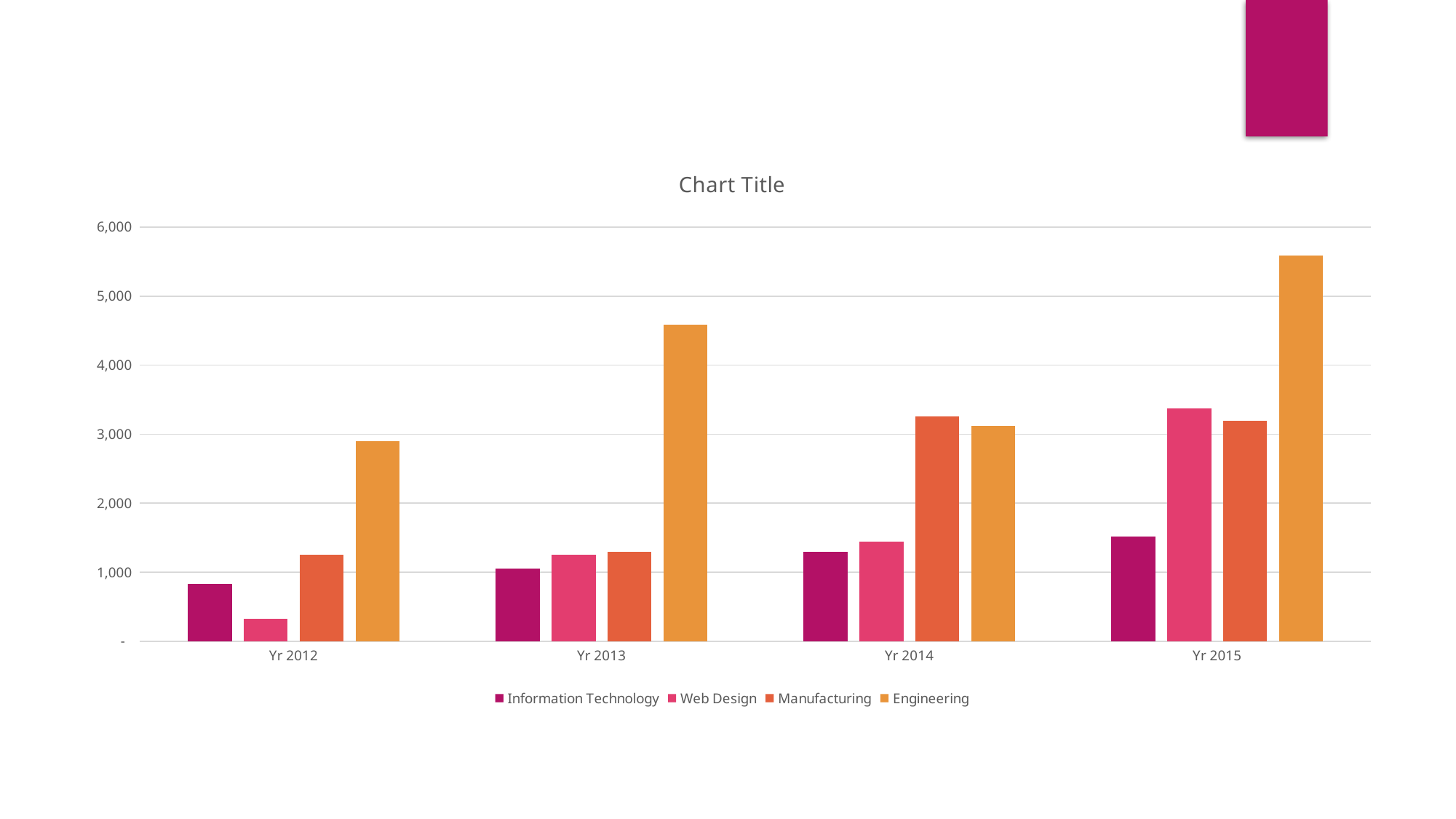
In Yr 2015, which is larger: Web Design or Information Technology? Web Design How many series does the legend list? 4 Do the Information Technology values rise or fall from Yr 2012 to Yr 2015? rise What is the title of the chart? Chart Title Which series has the tallest bar in Yr 2015? Engineering How many year categories are shown on the x axis? 4 What kind of chart is shown on the slide? bar chart Which series has the shortest bar in Yr 2012? Web Design Is the value for Web Design in Yr 2012 greater or less than 1,000? less Is the value for Engineering in Yr 2013 greater or less than 4,000? greater Is the value for Manufacturing in Yr 2014 greater or less than 3,000? greater Which series has the highest value in Yr 2013? Engineering